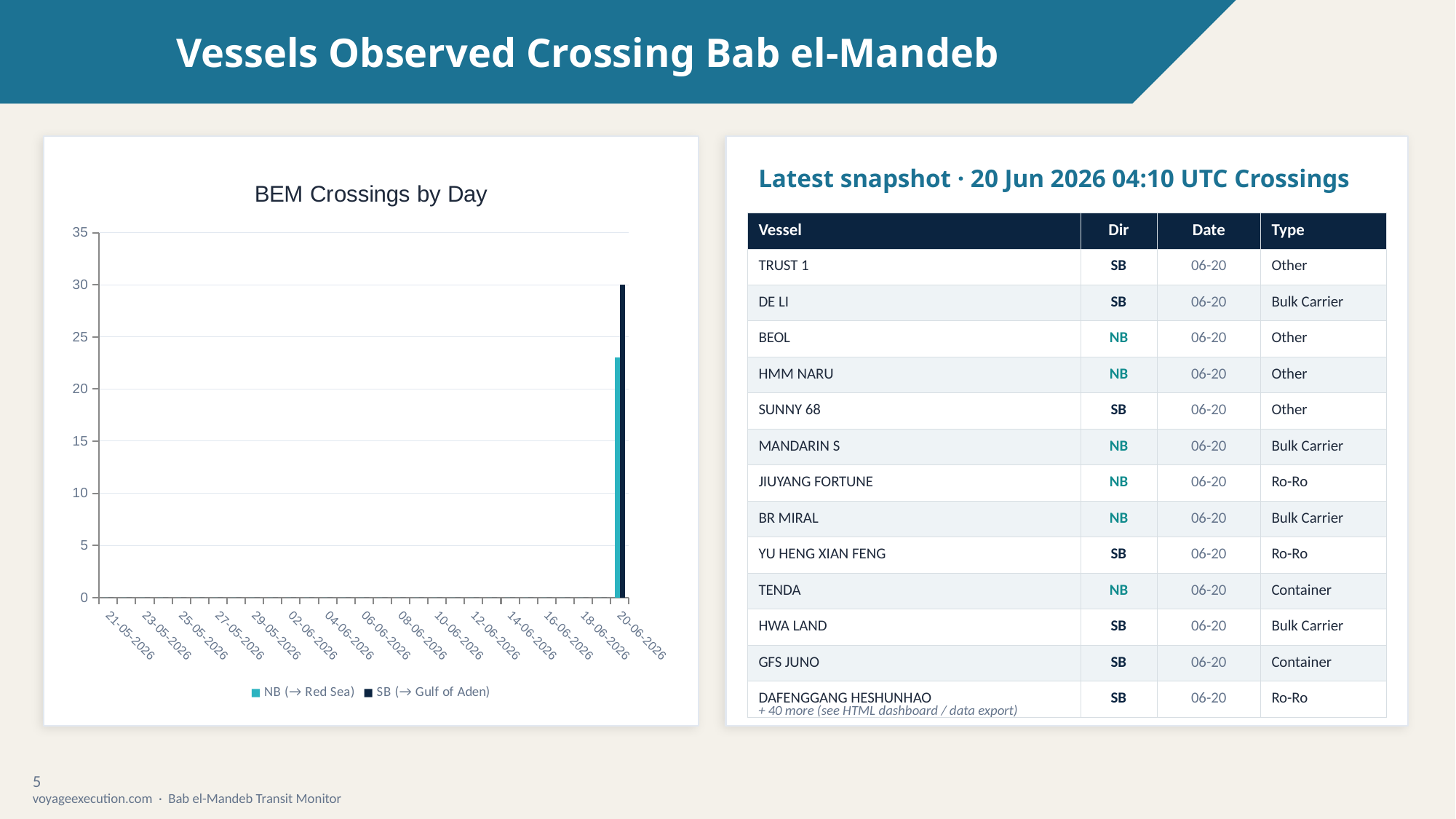
In 'BEM Crossings by Day', what is the highest value shown on the vertical axis? 35 In 'BEM Crossings by Day', which series has the larger value on 20-06-2026, NB (→ Red Sea) or SB (→ Gulf of Aden)? SB (→ Gulf of Aden) In 'BEM Crossings by Day', is the NB (→ Red Sea) value for 20-06-2026 greater or less than 20? greater How many series does the legend of 'BEM Crossings by Day' list? 2 What are the two legend entries in 'BEM Crossings by Day'? NB (→ Red Sea) and SB (→ Gulf of Aden) What is the title of the chart on the left of the slide? BEM Crossings by Day In 'BEM Crossings by Day', is the SB (→ Gulf of Aden) value for 20-06-2026 greater or less than 25? greater In 'BEM Crossings by Day', is the SB (→ Gulf of Aden) value for 20-06-2026 greater or less than 35? less What kind of chart is 'BEM Crossings by Day'? bar chart In 'BEM Crossings by Day', which date has the highest number of crossings? 20-06-2026